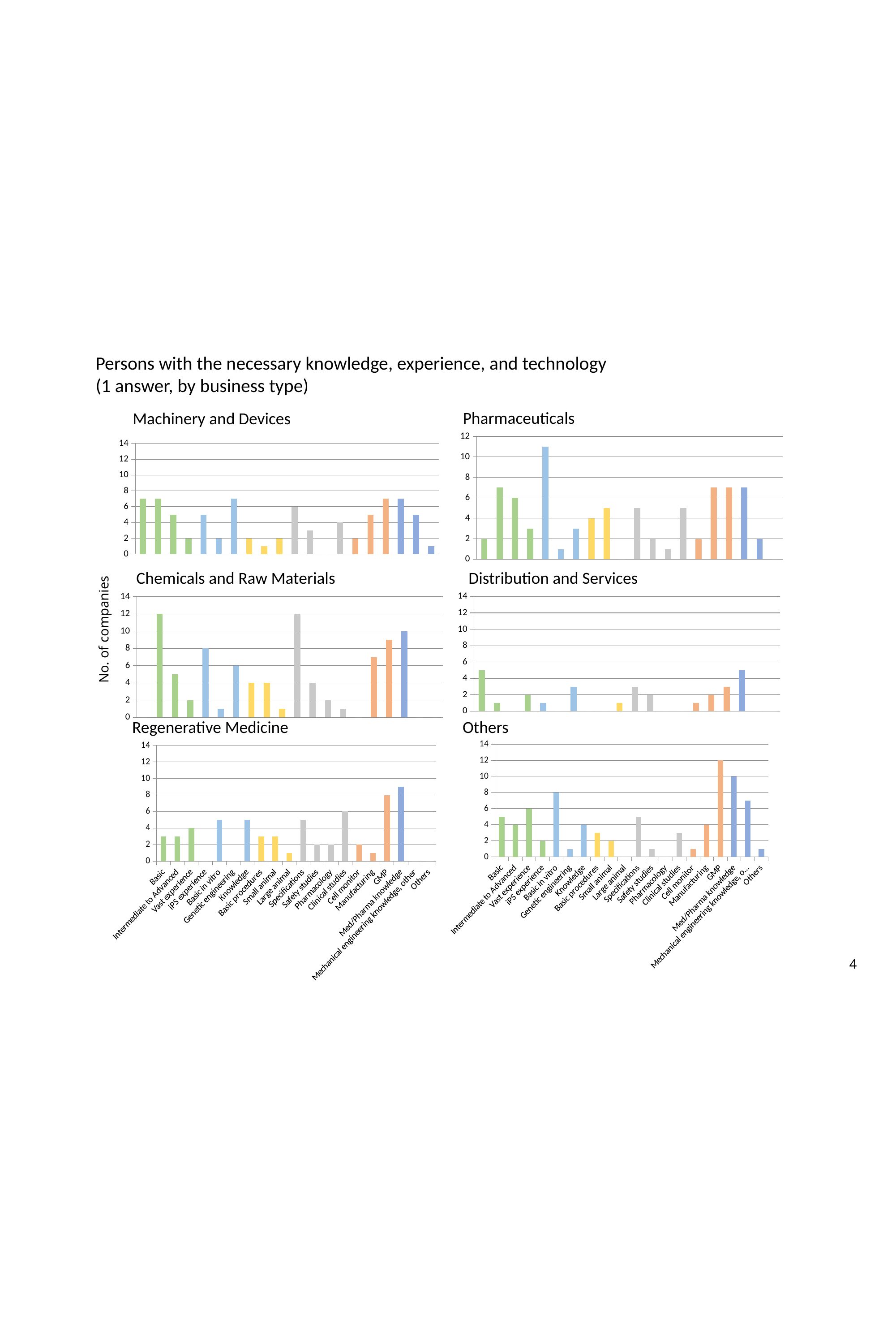
In the Others chart, what is the value for Med/Pharma knowledge? 10 In the Regenerative Medicine chart, what is the value for Clinical studies? 6 In the Regenerative Medicine chart, which category has the highest value? Med/Pharma knowledge In the Others chart, which category has the highest value? GMP In the Regenerative Medicine chart, which is larger, the value for Clinical studies or the value for Specifications? Clinical studies In the Others chart, what is the difference between the values for GMP and Med/Pharma knowledge? 2 What kind of chart is the Chemicals and Raw Materials chart? bar chart How many charts are shown on the slide? 6 In the Others chart, what is the value for Basic in vitro? 8 In the Pharmaceuticals chart, is the tallest bar greater or less than 10? greater In the Others chart, what is the value for GMP? 12 In the Regenerative Medicine chart, what is the value for GMP? 8